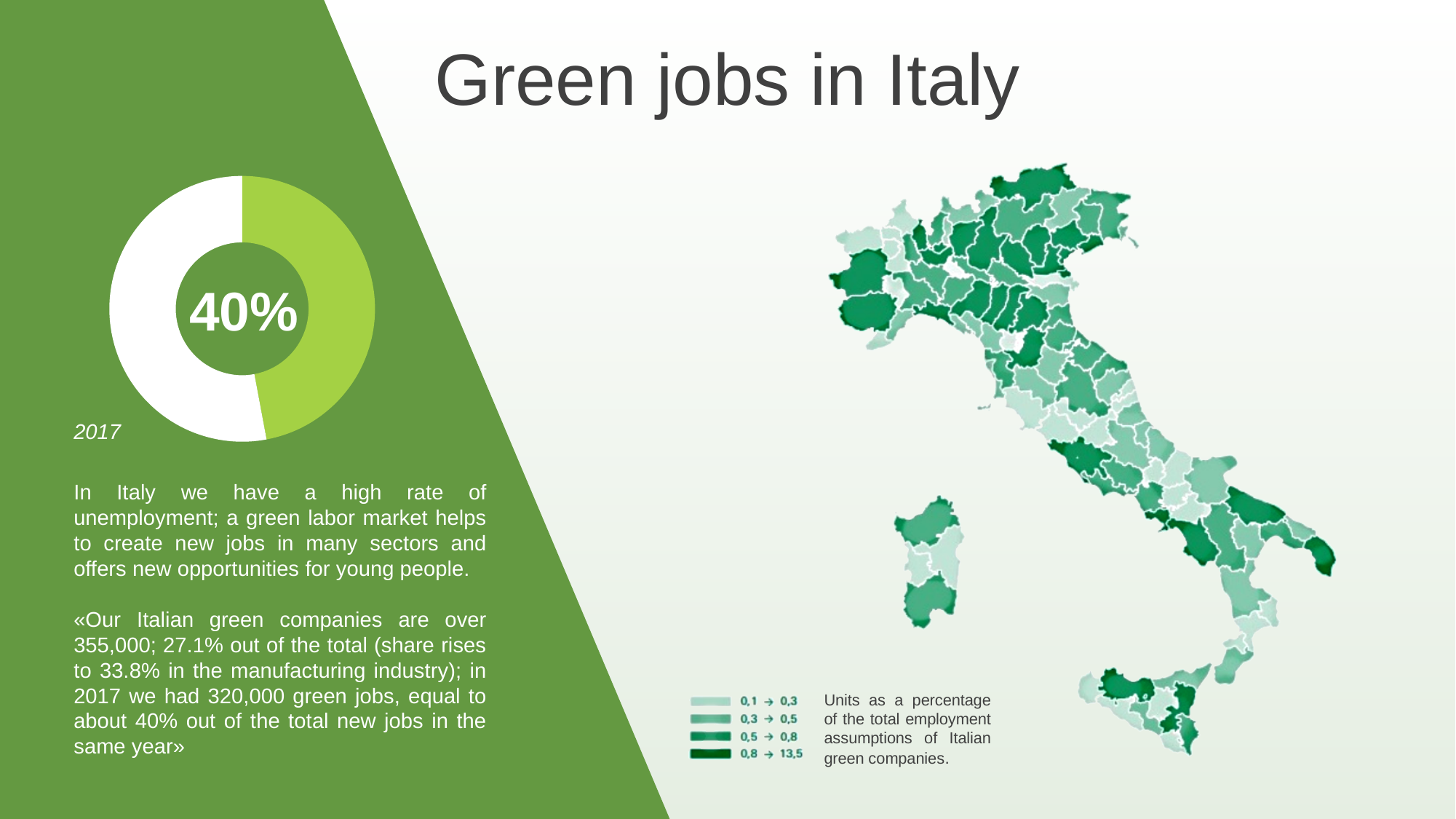
What year is labelled next to the donut chart on the left? 2017 On the map of Italy, what is the lowest value range shown in the legend? 0,1 → 0,3 On the map of Italy, what do the legend units represent according to the note beside the legend? Percentage of the total employment assumptions of Italian green companies On the donut chart on the left, which segment is larger, the green one or the white one? White On the map of Italy, what is the highest value range shown in the legend? 0,8 → 13,5 On the map of Italy, how many value ranges does the legend list? 4 On the donut chart on the left, what percentage is displayed in the centre? 40% On the map of Italy, what is the upper bound of the second legend range (0,3 → ?)? 0,5 What kind of chart is shown on the right side of the slide? Map (choropleth map of Italy) What kind of chart is shown on the left of the slide with the 40% label? Donut chart